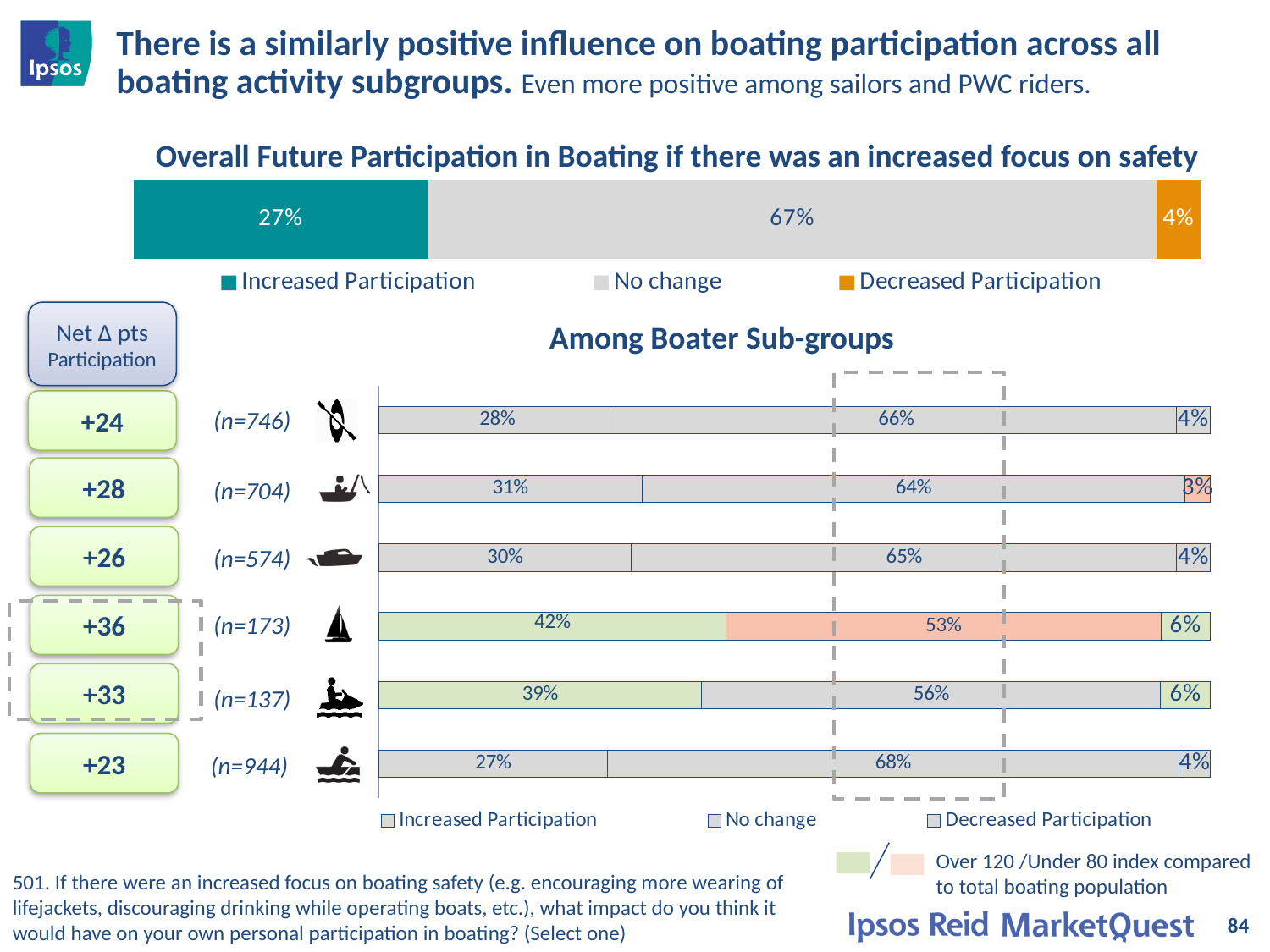
How many sub-group rows are plotted in the 'Among Boater Sub-groups' chart? 6 How many series does the legend of the 'Overall Future Participation in Boating if there was an increased focus on safety' chart list? 3 In the 'Among Boater Sub-groups' chart, which row has the larger Decreased Participation value, (n=704) or (n=173)? (n=173) What kind of chart is the 'Overall Future Participation in Boating if there was an increased focus on safety' chart? Stacked bar chart What Net Δ pts Participation value is shown next to the (n=173) row in the 'Among Boater Sub-groups' chart? +36 In the 'Among Boater Sub-groups' chart, what is the No change value for the row labeled (n=944)? 68% In the 'Among Boater Sub-groups' chart, what is the Increased Participation value for the row labeled (n=173)? 42% In the 'Overall Future Participation in Boating if there was an increased focus on safety' chart, what percentage is shown for Increased Participation? 27% In the 'Overall Future Participation in Boating if there was an increased focus on safety' chart, what percentage is shown for No change? 67% In the 'Among Boater Sub-groups' chart, which row has the highest Increased Participation value? (n=173) In the 'Among Boater Sub-groups' chart, what is the difference between the Increased Participation values for the (n=173) row and the (n=137) row? 3 percentage points In the 'Among Boater Sub-groups' chart, which row has the lowest No change value? (n=173)